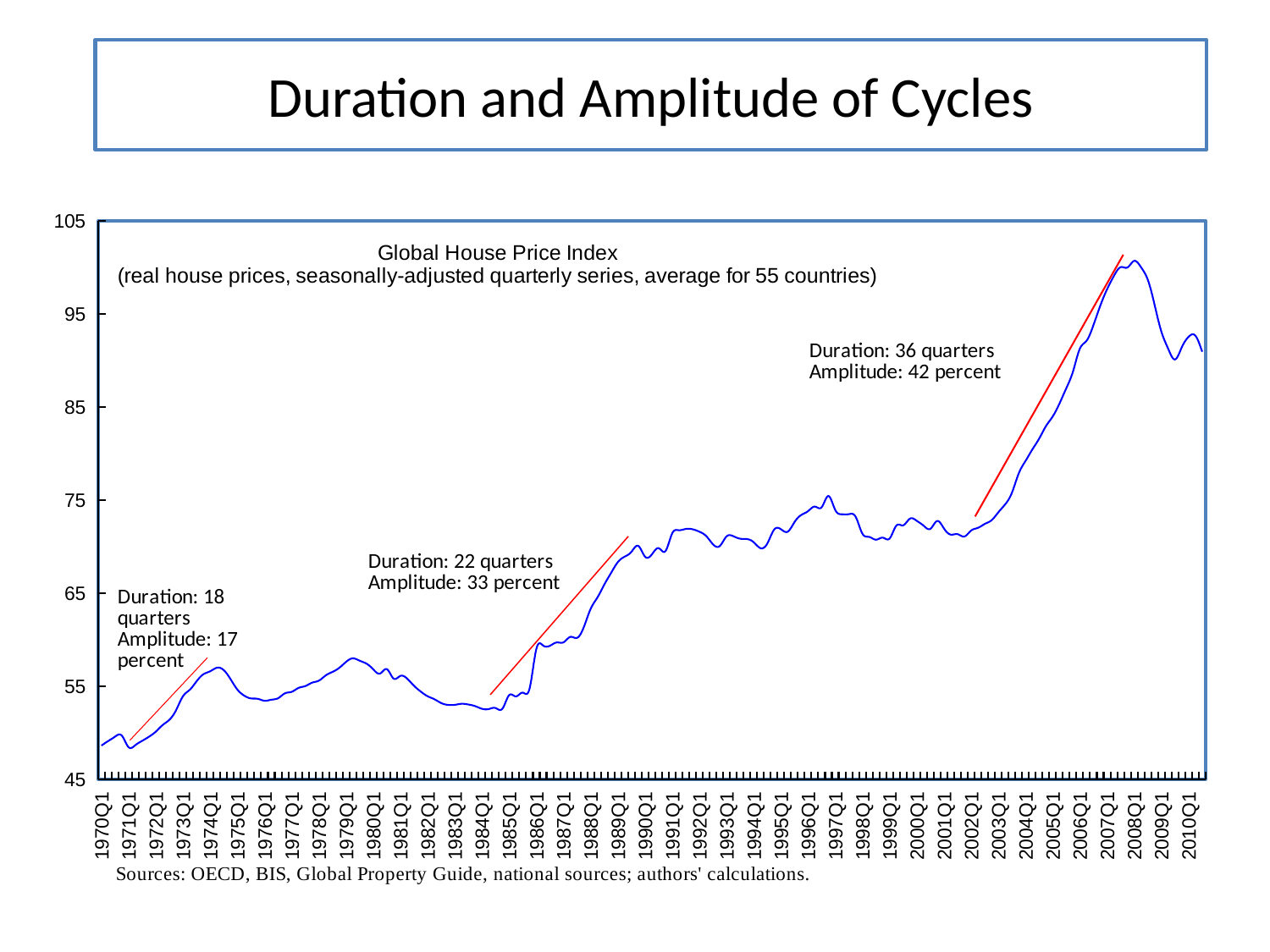
What kind of chart is shown on the slide? line chart Is the value of the index at 1990Q1 greater or less than 65? greater What is the duration of the cycle annotated in the mid-1980s? 22 quarters According to the chart subtitle, how many countries are averaged in the Global House Price Index? 55 What is the duration of the cycle annotated in the 1970s? 18 quarters Is the value of the index at 2008Q1 greater or less than 95? greater What is the amplitude of the cycle annotated from 2002 onward? 42 percent Is the value of the index at 1970Q1 greater or less than 55? less What is the amplitude of the cycle annotated in the 1970s? 17 percent Overall, does the Global House Price Index rise or fall from 1970Q1 to 2010Q1? rise What is the title printed inside the chart area? Global House Price Index Which of the three annotated cycles has the largest amplitude? the 36-quarter cycle (42 percent)